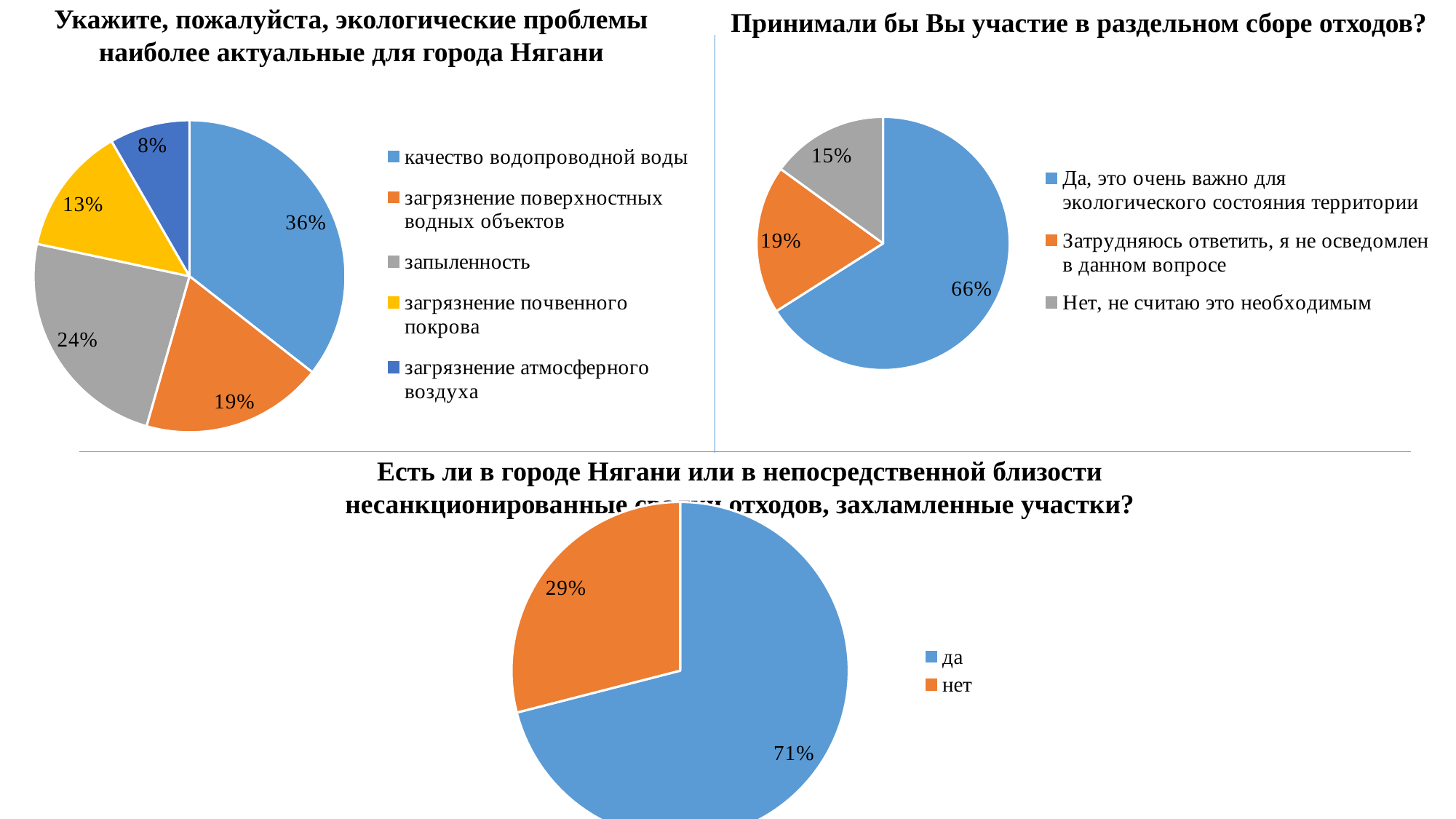
In the top-left chart (ecological problems of Nyagan), which category has the largest slice? качество водопроводной воды In the bottom chart (unauthorized dumps near Nyagan), what is the difference between the «да» and «нет» shares? 42% In the bottom chart (unauthorized dumps near Nyagan), what share answered «нет»? 29% In the top-left chart (ecological problems of Nyagan), how many categories does the legend list? 5 In the top-left chart (ecological problems of Nyagan), what is the difference between the shares for «запыленность» and «загрязнение почвенного покрова»? 11% What type of chart is used for all three charts on the slide? pie chart In the top-left chart (ecological problems of Nyagan), which category has the smallest slice? загрязнение атмосферного воздуха In the top-right chart (participation in separate waste collection), what share answered «Да, это очень важно для экологического состояния территории»? 66% In the top-left chart (ecological problems of Nyagan), what share is shown for «запыленность»? 24% In the top-right chart (participation in separate waste collection), which is larger: «Затрудняюсь ответить» or «Нет, не считаю это необходимым»? Затрудняюсь ответить